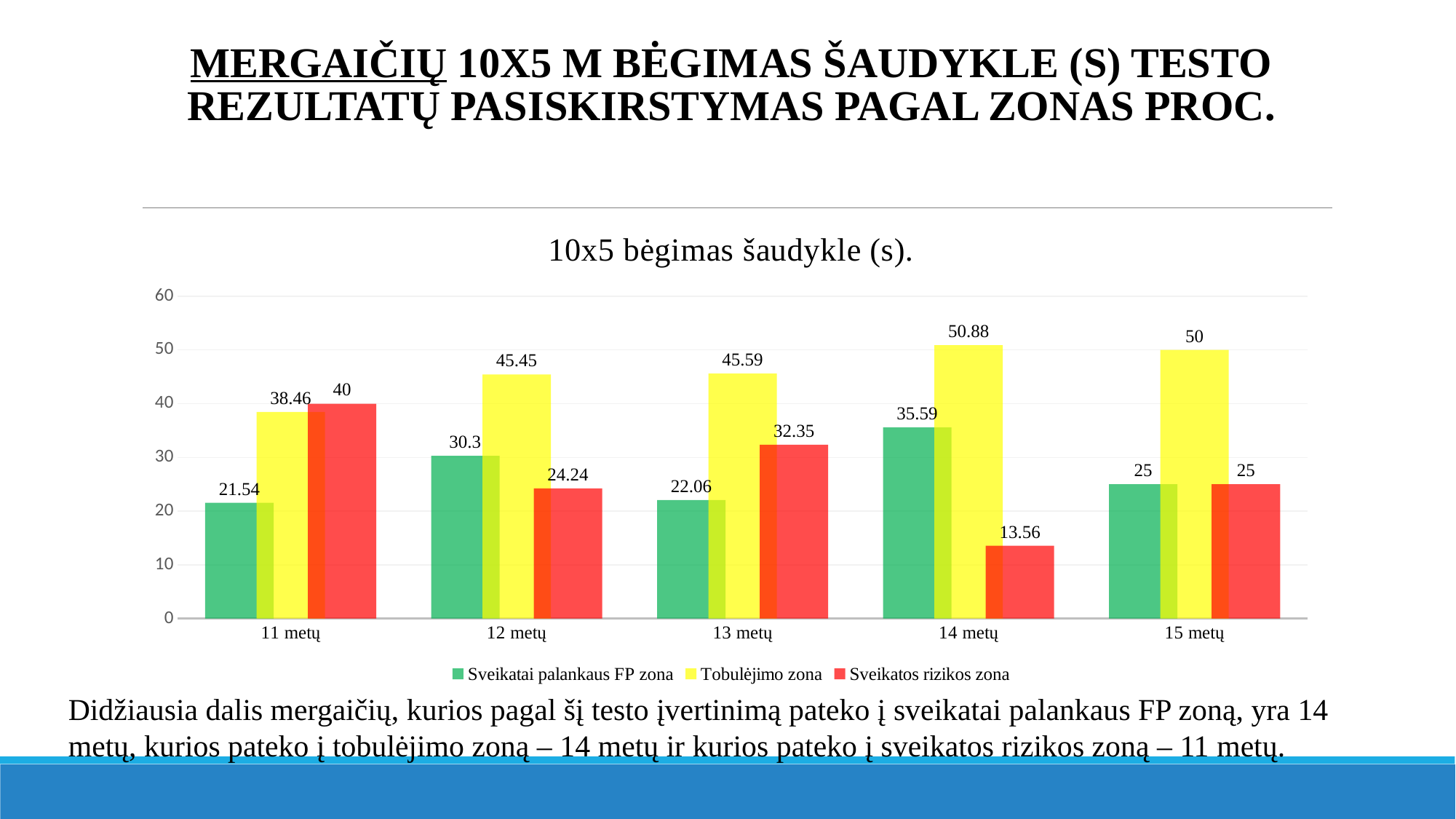
What is the value of Sveikatos rizikos zona for 11 metų? 40 How many age categories are shown on the x axis? 5 Is the value of Tobulėjimo zona for 11 metų greater or less than 40? less Which is larger for 12 metų: Sveikatai palankaus FP zona or Sveikatos rizikos zona? Sveikatai palankaus FP zona What is the value of Tobulėjimo zona for 14 metų? 50.88 What is the value of Sveikatai palankaus FP zona for 13 metų? 22.06 Which age category has the highest value for Sveikatai palankaus FP zona? 14 metų Which age category has the lowest value for Sveikatos rizikos zona? 14 metų What is the difference between Tobulėjimo zona and Sveikatos rizikos zona for 14 metų? 37.32 What is the title of the chart? 10x5 bėgimas šaudykle (s). What type of chart is shown on the slide? bar chart How many series does the legend list? 3